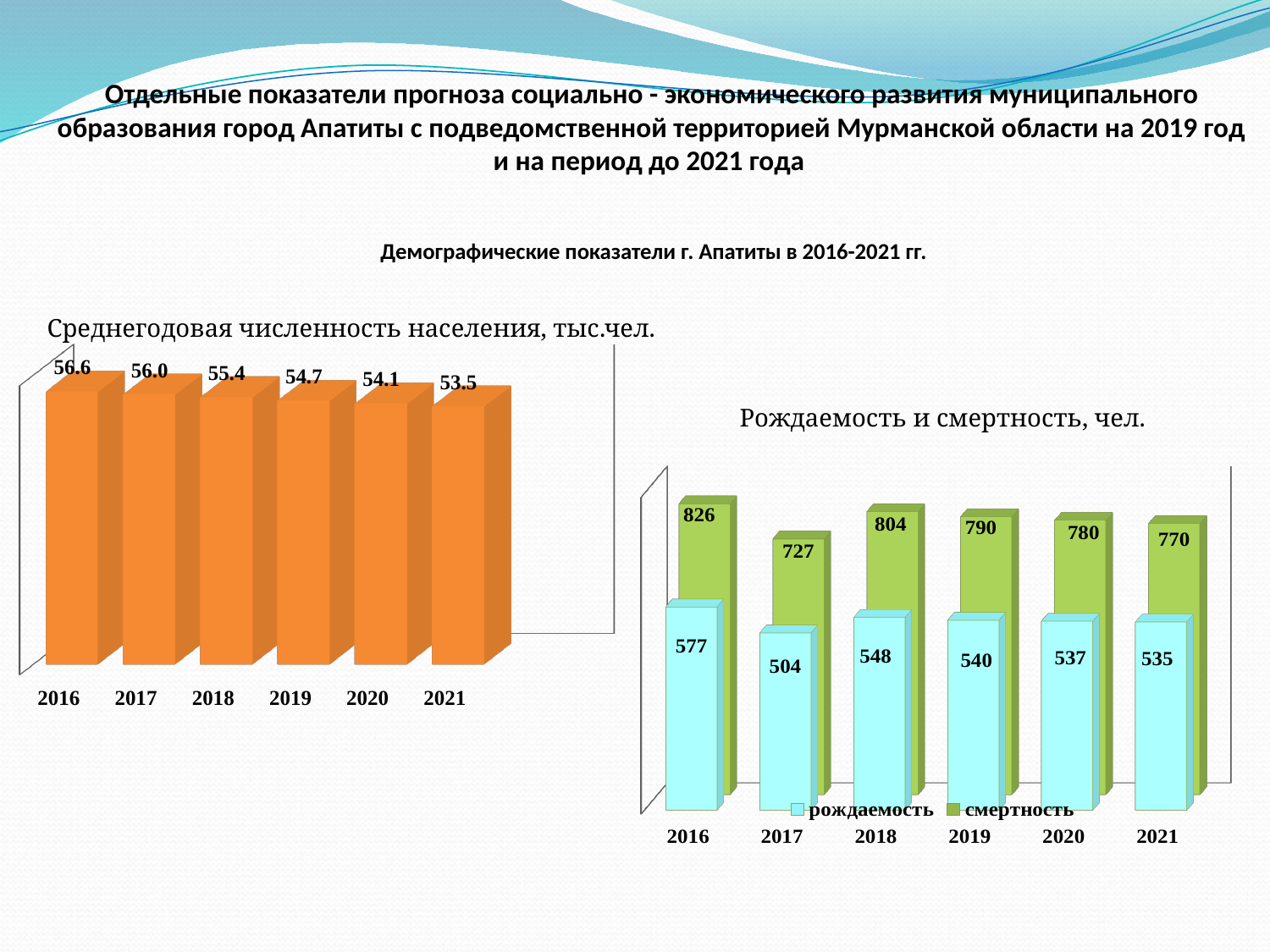
In the chart 'Среднегодовая численность населения, тыс.чел.', what is the difference between the 2016 and 2021 values? 3.1 How many years are shown in the chart 'Среднегодовая численность населения, тыс.чел.'? 6 In the chart 'Среднегодовая численность населения, тыс.чел.', which year has the highest value? 2016 What kind of chart is 'Рождаемость и смертность, чел.'? bar chart In the chart 'Рождаемость и смертность, чел.', what is the difference between смертность and рождаемость in 2016? 249 In the chart 'Рождаемость и смертность, чел.', what is the value of смертность for 2019? 790 In the chart 'Среднегодовая численность населения, тыс.чел.', do the values rise or fall from 2016 to 2021? fall In the chart 'Рождаемость и смертность, чел.', which year has the lowest рождаемость? 2017 In the chart 'Рождаемость и смертность, чел.', which is larger in 2021: рождаемость or смертность? смертность In the chart 'Рождаемость и смертность, чел.', what is the value of рождаемость for 2017? 504 How many series does the legend of the chart 'Рождаемость и смертность, чел.' list? 2 In the chart 'Среднегодовая численность населения, тыс.чел.', what is the value for 2018? 55.4